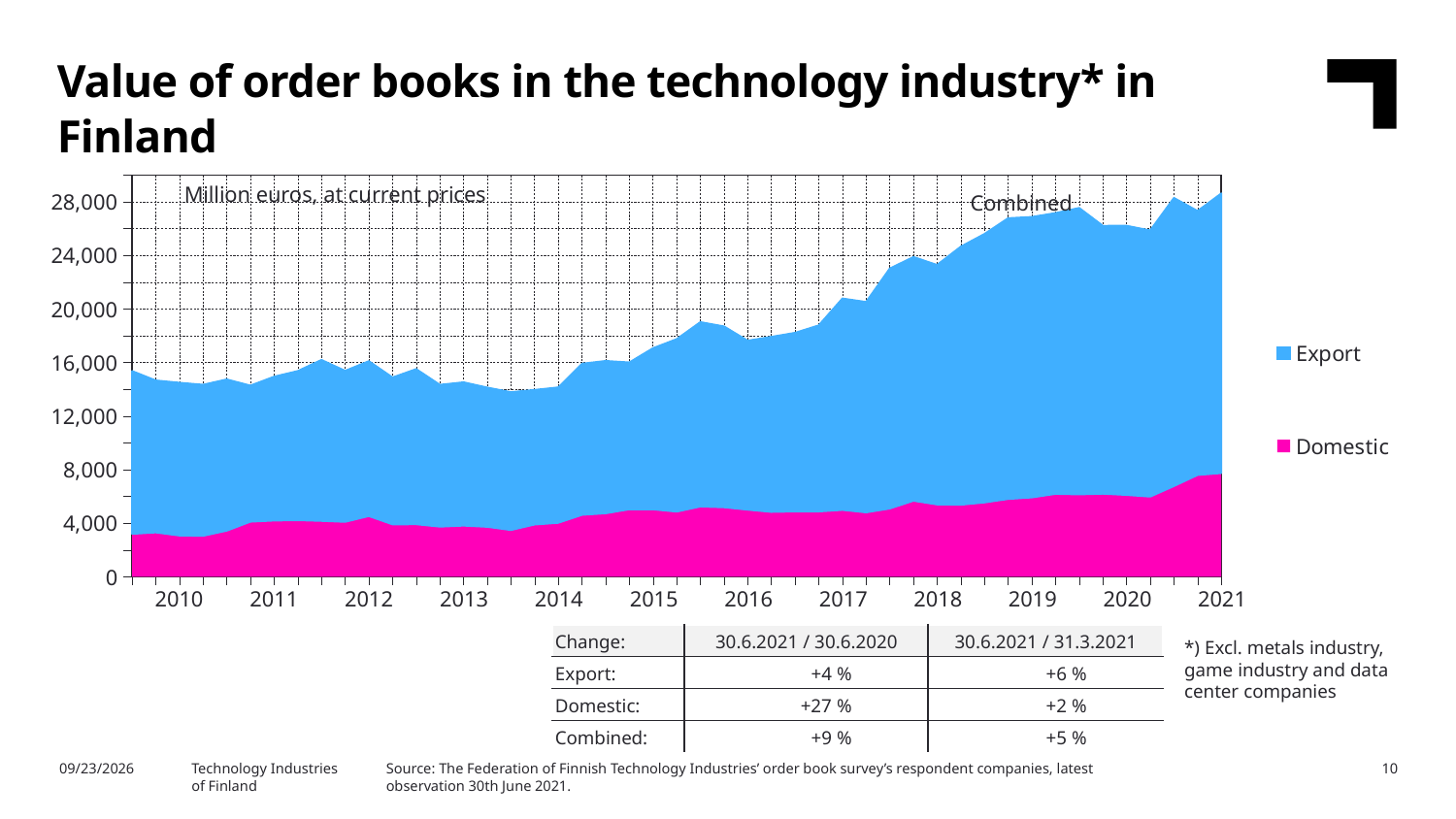
What kind of chart is shown on the slide? area chart Is the combined value of order books in 2021 greater or less than 24,000? greater Is the combined value of order books at the start of 2010 greater or less than 20,000? less Is the Domestic value at the start of 2010 greater or less than 4,000? less What are the two series named in the legend? Export and Domestic Which is larger, the combined value of order books in 2010 or in 2021? 2021 Does the combined value of order books rise or fall between 2017 and 2019? rise What unit label is shown at the top of the chart? Million euros, at current prices How many series does the legend list? 2 How many years are labelled on the x axis? 12